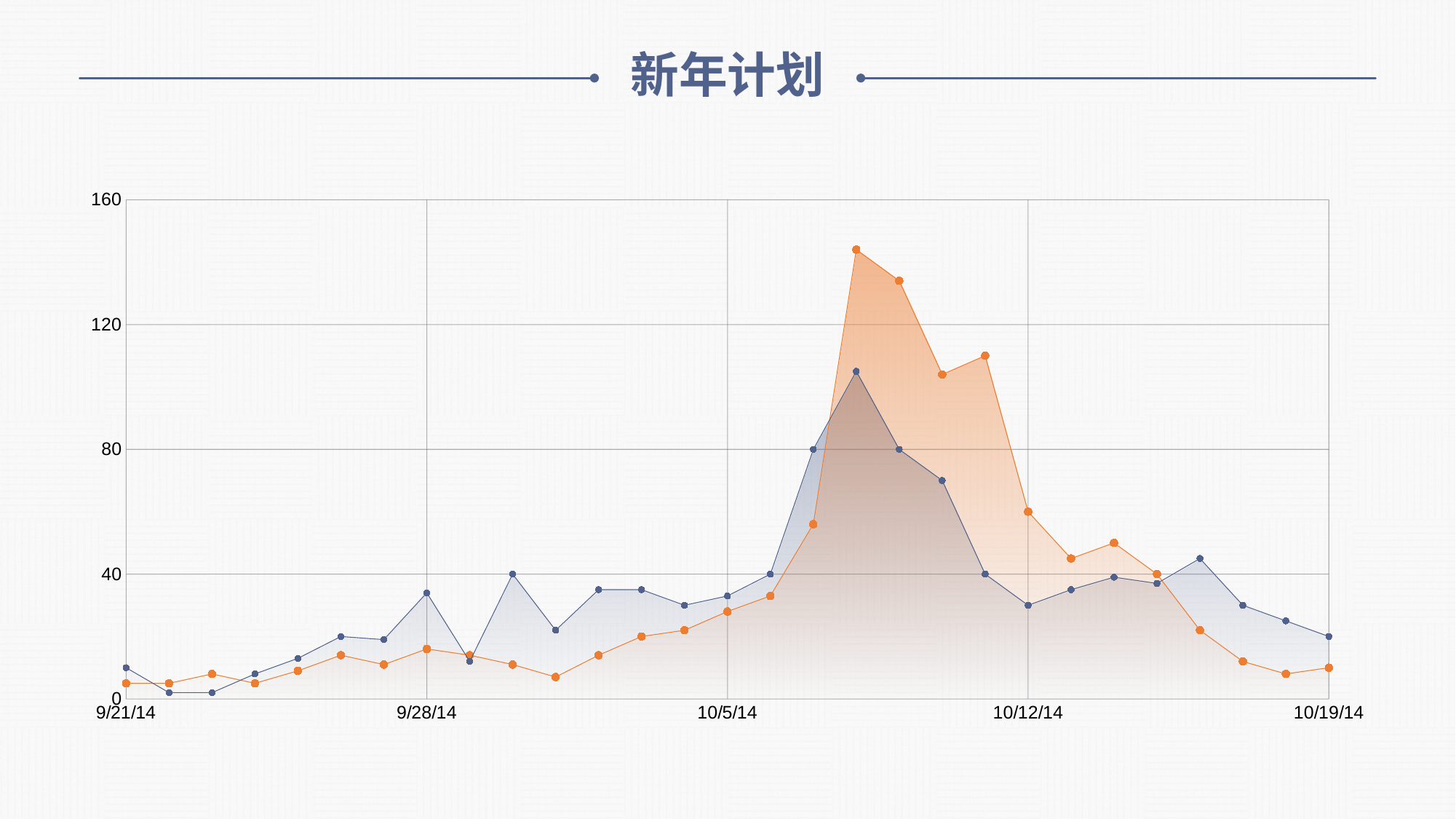
Does the orange series rise or fall between 10/12/14 and 10/19/14? fall What kind of chart is shown on the slide? line chart Is the peak value of the orange series greater or less than 120? greater At 10/12/14, which series has the larger value, orange or blue? orange Is the peak value of the blue series greater or less than 120? less At 9/28/14, which series has the larger value, orange or blue? blue Is the value of the orange series at 10/12/14 greater or less than 40? greater What is the highest value shown on the vertical axis of the chart? 160 Which series reaches the highest value in the chart, the orange one or the blue one? orange What is the title of the chart on this slide? 新年计划 How many data series are plotted in the chart? 2 How many data points does each series in the chart have? 29